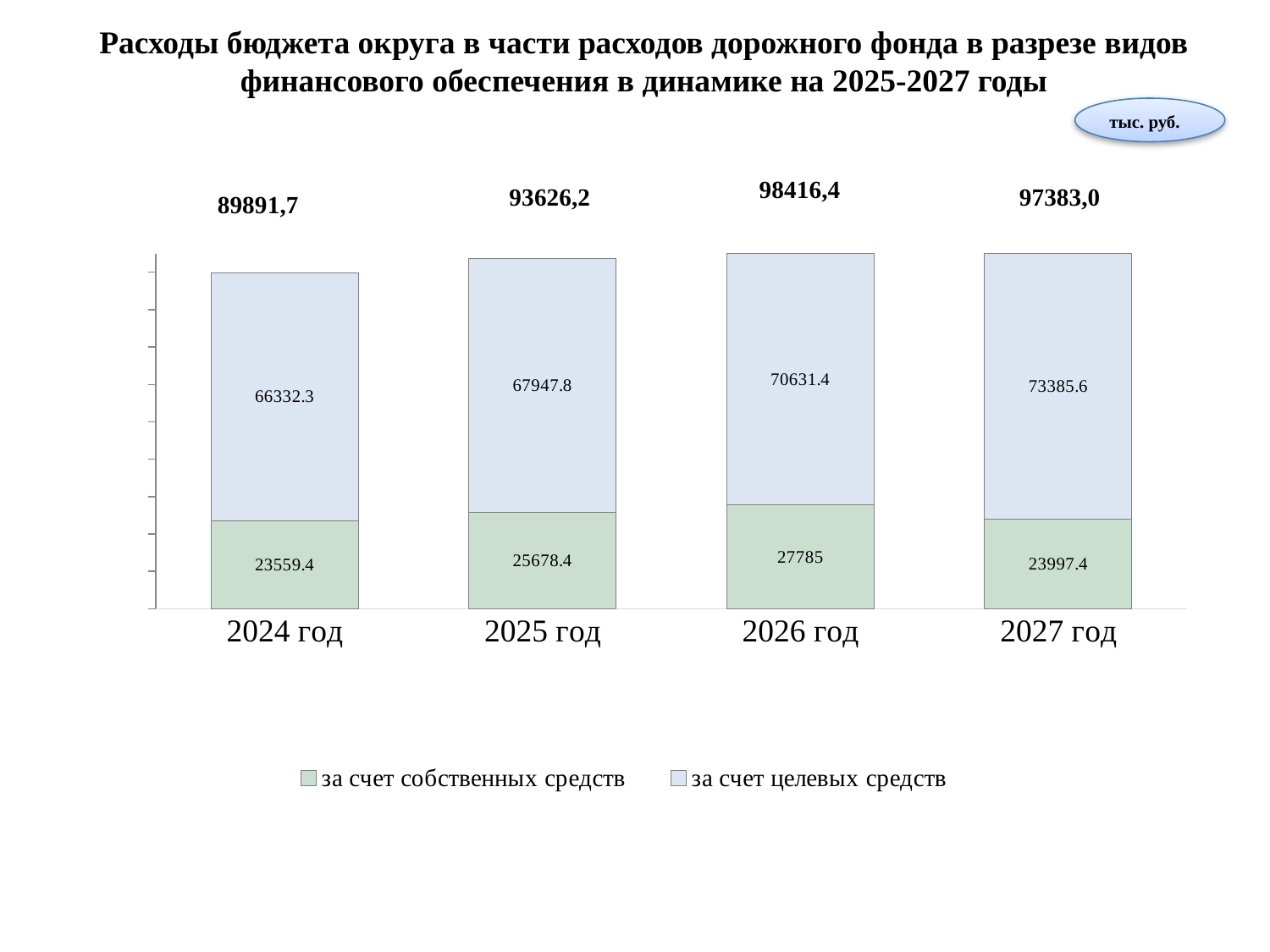
Which year has the highest value for "за счет собственных средств"? 2026 год What is the value for "за счет собственных средств" in 2024 год? 23559.4 How many years are shown on the x axis? 4 What is the value for "за счет целевых средств" in 2026 год? 70631.4 What is the difference between the "за счет целевых средств" values for 2027 год and 2026 год? 2754.2 What kind of chart is shown on the slide? Stacked bar chart Do the "за счет целевых средств" values rise or fall from 2024 год to 2027 год? Rise Which year has the lowest total bar? 2024 год What is the value for "за счет целевых средств" in 2025 год? 67947.8 How many series does the legend list? 2 What is the total of the stacked bar for 2026 год? 98416,4 Which is larger: the "за счет собственных средств" value for 2025 год or for 2027 год? 2025 год